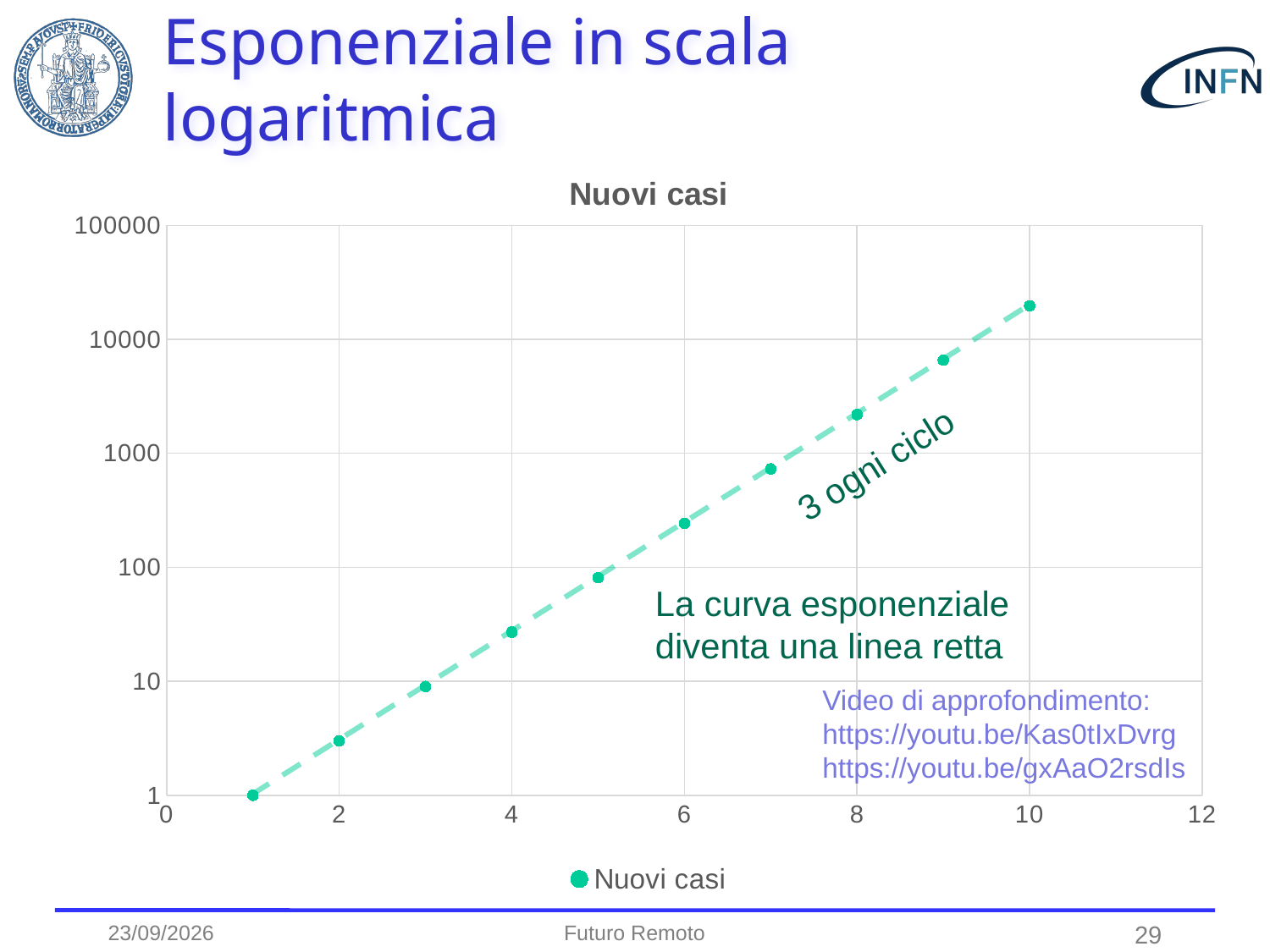
Which x value has the highest Nuovi casi value? 10 How many data points are plotted in the chart? 10 Is the value of Nuovi casi at x = 8 greater or less than 1000? greater Is the value of Nuovi casi at x = 10 greater or less than 10000? greater How many series does the legend list? 1 Which is larger, the value of Nuovi casi at x = 7 or at x = 4? x = 7 What kind of chart is shown on the slide? scatter chart What is the title of the chart? Nuovi casi What is the value of Nuovi casi at x = 1? 1 Is the value of Nuovi casi at x = 5 greater or less than 100? less Do the values of Nuovi casi rise or fall as x increases? rise